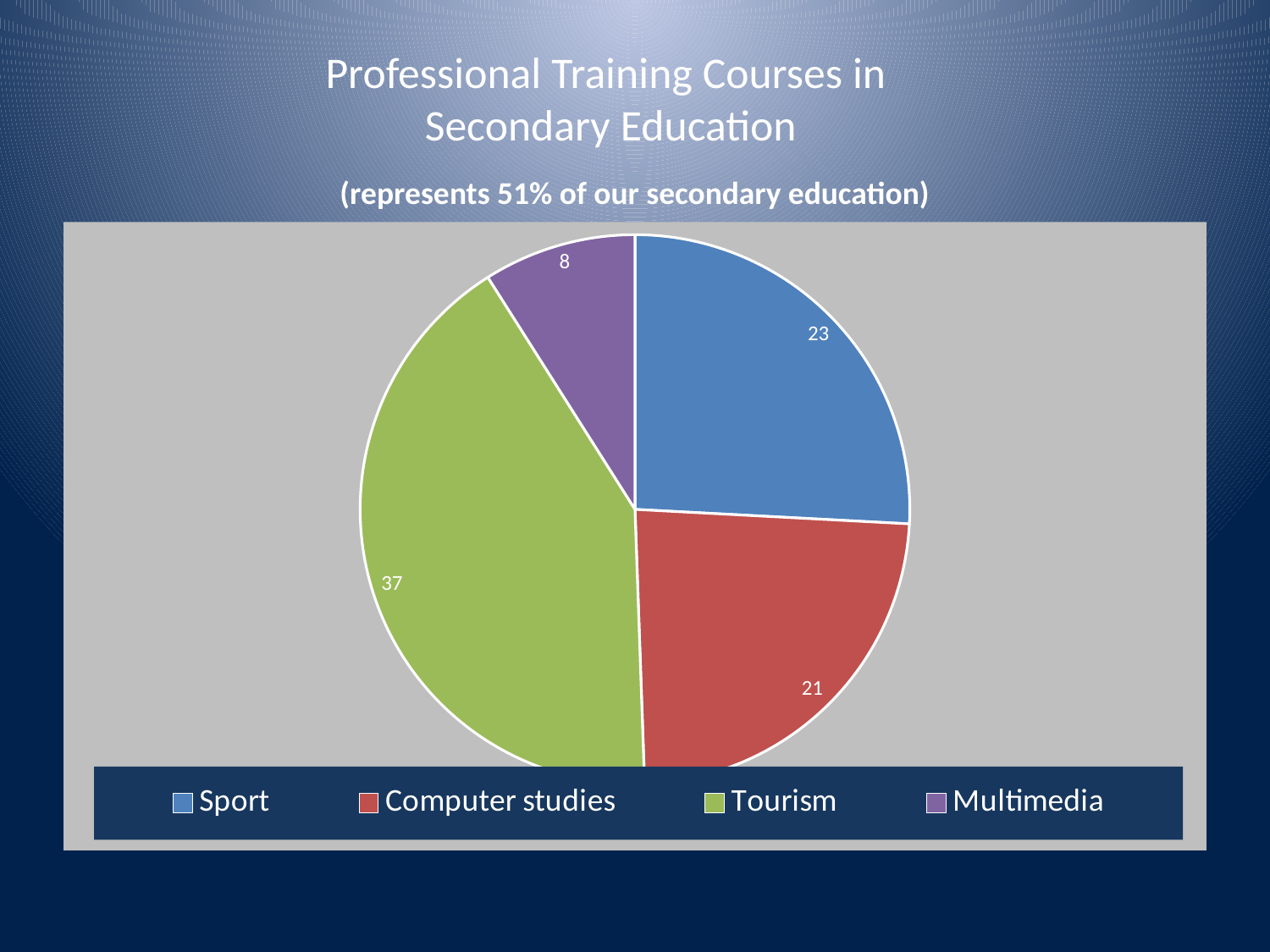
How many categories does the pie chart have? 4 What is the value for Multimedia? 8 What is the value for Tourism? 37 Which category has the largest slice? Tourism What is the total of all the slices in the pie chart? 89 What is the value for Sport? 23 Which is larger, the value for Tourism or the value for Computer studies? Tourism Which category has the smallest slice? Multimedia What kind of chart is shown on the slide? pie chart What is the difference between the values for Sport and Multimedia? 15 What is the value for Computer studies? 21 What is the difference between the values for Tourism and Sport? 14